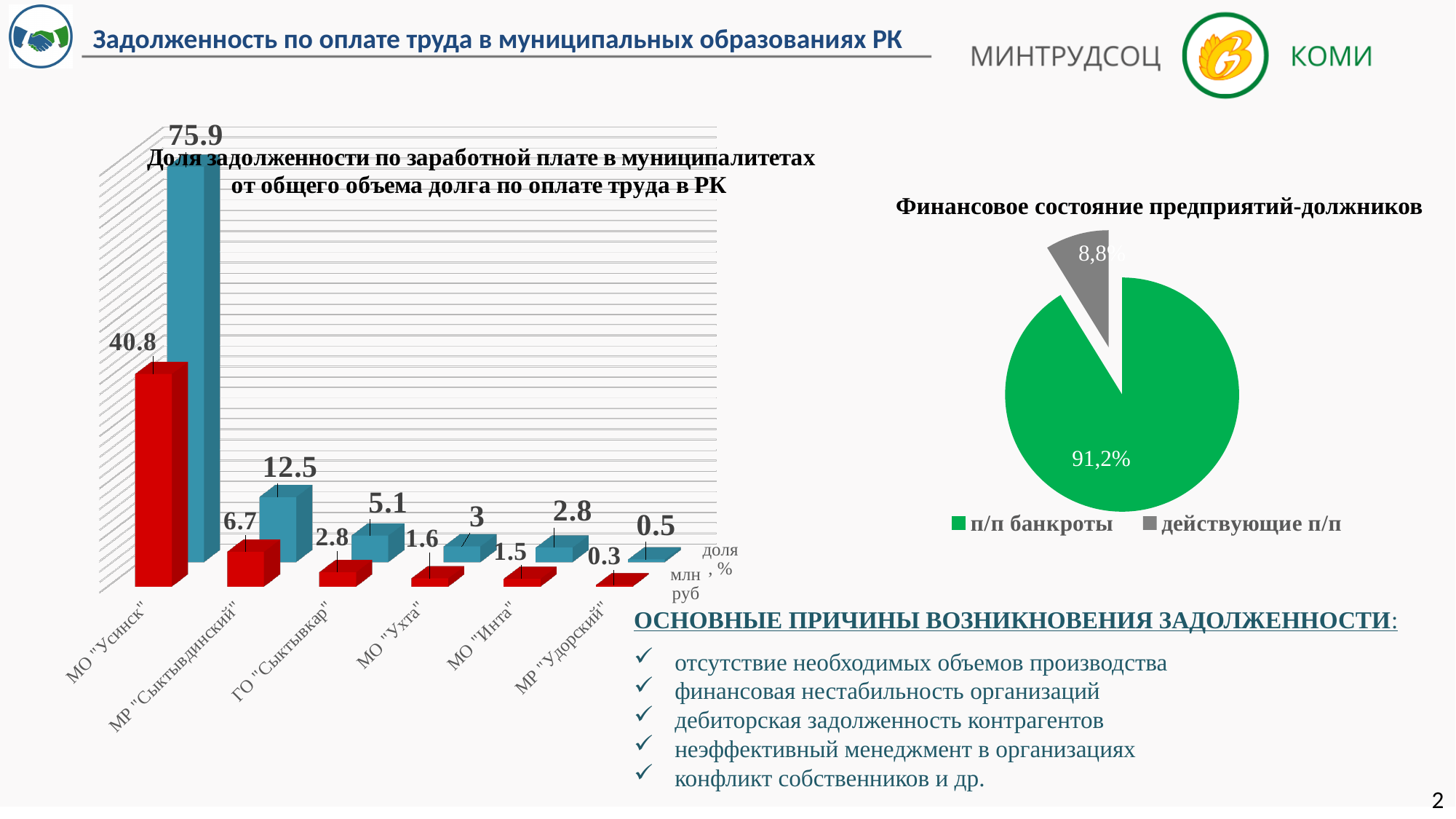
What type of chart is the chart on the left of the slide? Bar chart In the bar chart on the left, which municipality has the highest доля, % value? МО "Усинск" In the pie chart "Финансовое состояние предприятий-должников", what share is п/п банкроты? 91,2% How many entries does the legend of the pie chart "Финансовое состояние предприятий-должников" list? 2 In the bar chart on the left, what is the difference between the доля, % values for МО "Усинск" and МР "Сыктывдинский"? 63.4 In the bar chart on the left, what is the value in млн руб for ГО "Сыктывкар"? 2.8 In the bar chart on the left, which municipality has the lowest value in млн руб? МР "Удорский" In the bar chart on the left, which is larger: the млн руб value for МО "Ухта" or for МО "Инта"? МО "Ухта" In the bar chart on the left, what is the доля, % value for МР "Сыктывдинский"? 12.5 How many municipalities are shown in the bar chart on the left? 6 In the pie chart "Финансовое состояние предприятий-должников", what share is действующие п/п? 8,8% In the bar chart on the left, what is the value in млн руб for МО "Усинск"? 40.8